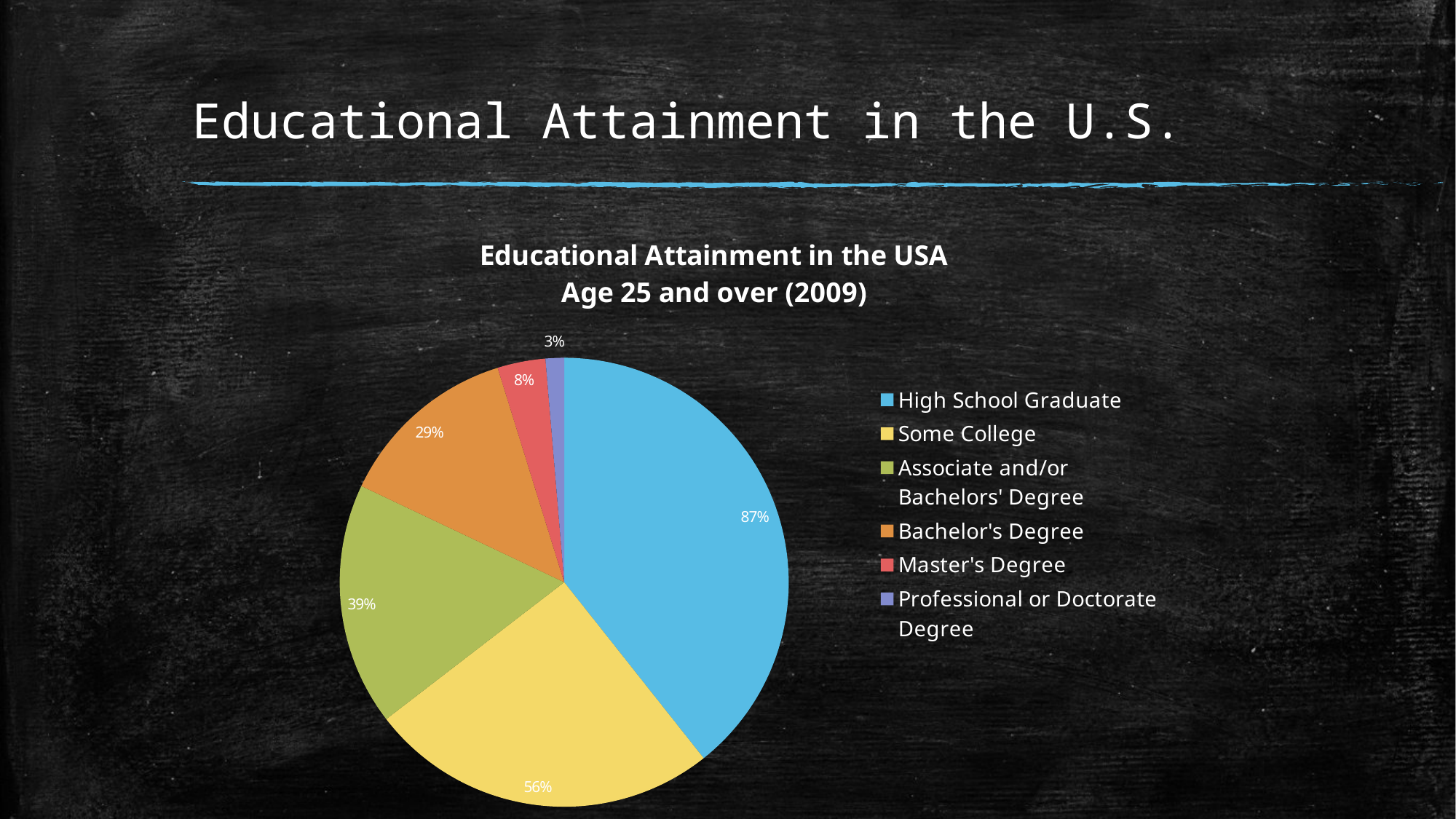
What value is labelled on the Master's Degree slice? 8% What value is labelled on the Bachelor's Degree slice? 29% What is the title of the chart? Educational Attainment in the USA Age 25 and over (2009) Which category has the smallest slice of the pie? Professional or Doctorate Degree What value is labelled on the Associate and/or Bachelors' Degree slice? 39% Which category has the largest slice of the pie? High School Graduate What value is labelled on the Professional or Doctorate Degree slice? 3% How many categories does the legend list? 6 What is the difference between the labelled values for High School Graduate and Some College? 31% What type of chart is shown on the slide? Pie chart What value is labelled on the Some College slice? 56% What value is labelled on the High School Graduate slice? 87%